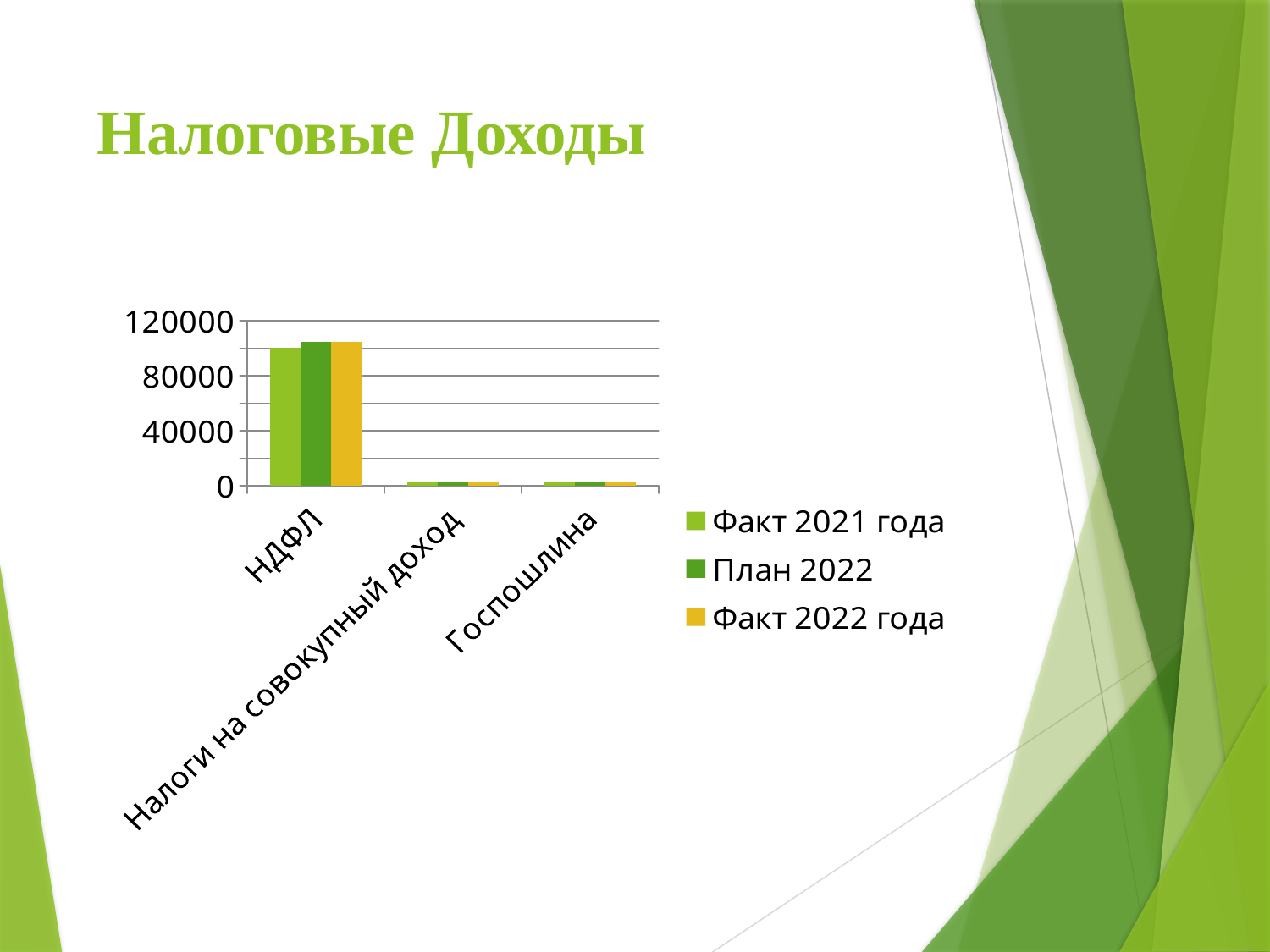
What is the title of the slide with the chart? Налоговые Доходы What kind of chart is shown on the slide? bar chart Which category has the highest values in the chart? НДФЛ Which series is shown in yellow in the chart legend? Факт 2022 года Which is larger in the Факт 2022 года series: НДФЛ or Госпошлина? НДФЛ Is the value for Госпошлина in the План 2022 series greater or less than 40000? less Is the value for НДФЛ in the Факт 2021 года series greater or less than 80000? greater What is the highest value shown on the vertical axis of the chart? 120000 Which is larger in the План 2022 series: Налоги на совокупный доход or НДФЛ? НДФЛ How many series does the chart legend list? 3 Is the value for НДФЛ in the Факт 2022 года series greater or less than 120000? less How many categories are shown on the x axis of the chart? 3